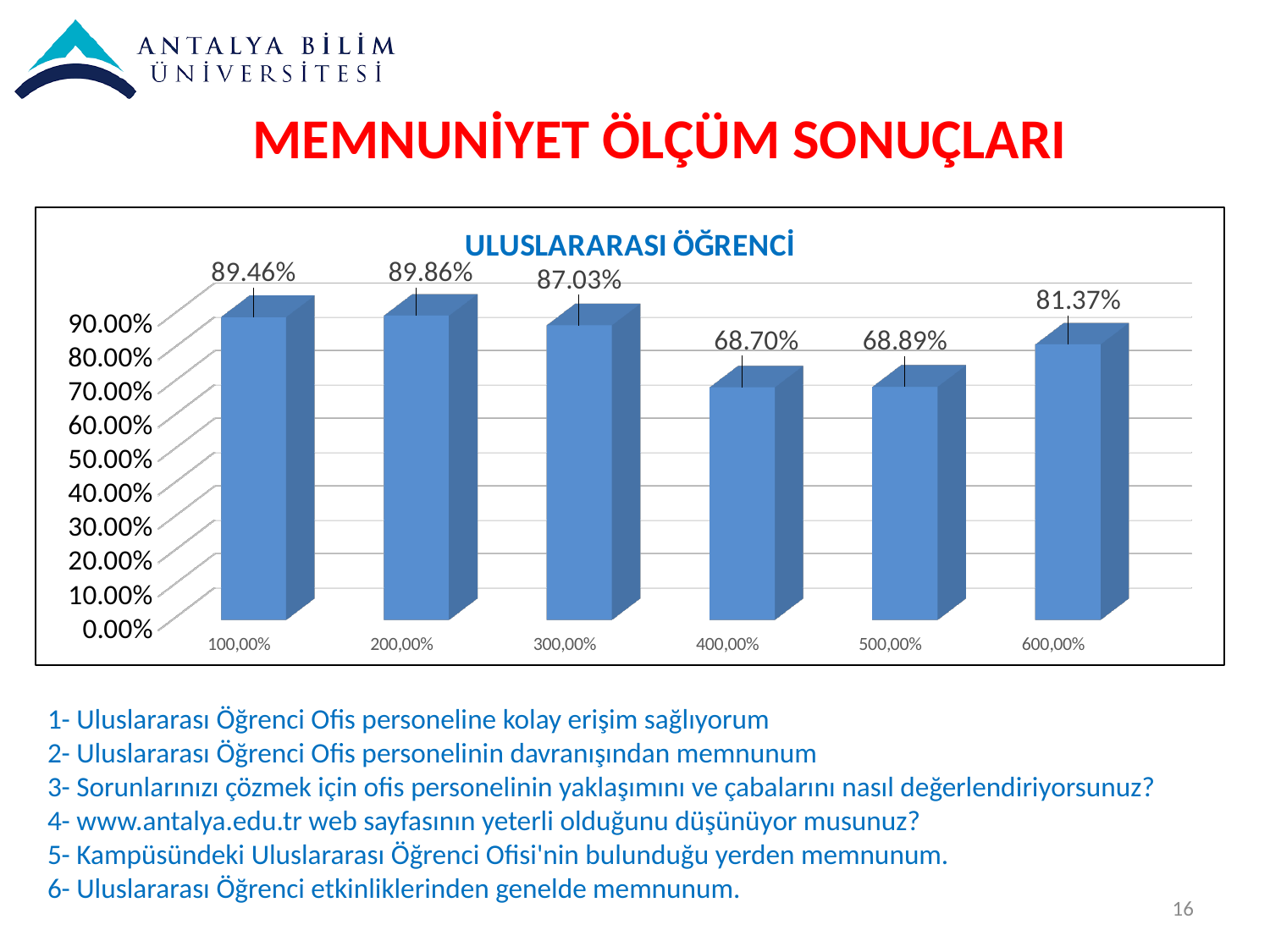
What is the title of the chart? ULUSLARARASI ÖĞRENCİ How many bars are plotted in the chart? 6 What is the difference between the values for 200,00% and 400,00%? 21.16% What is the value of the bar labelled 400,00%? 68.70% What is the value of the bar labelled 100,00%? 89.46% Which category has the highest value in the chart? 200,00% What is the difference between the values for 600,00% and 500,00%? 12.48% What is the value of the bar labelled 600,00%? 81.37% What kind of chart is shown on the slide? bar chart Which is larger, the value for 300,00% or the value for 600,00%? 300,00% Is the value for 500,00% greater or less than 80.00%? less Which category has the lowest value in the chart? 400,00%